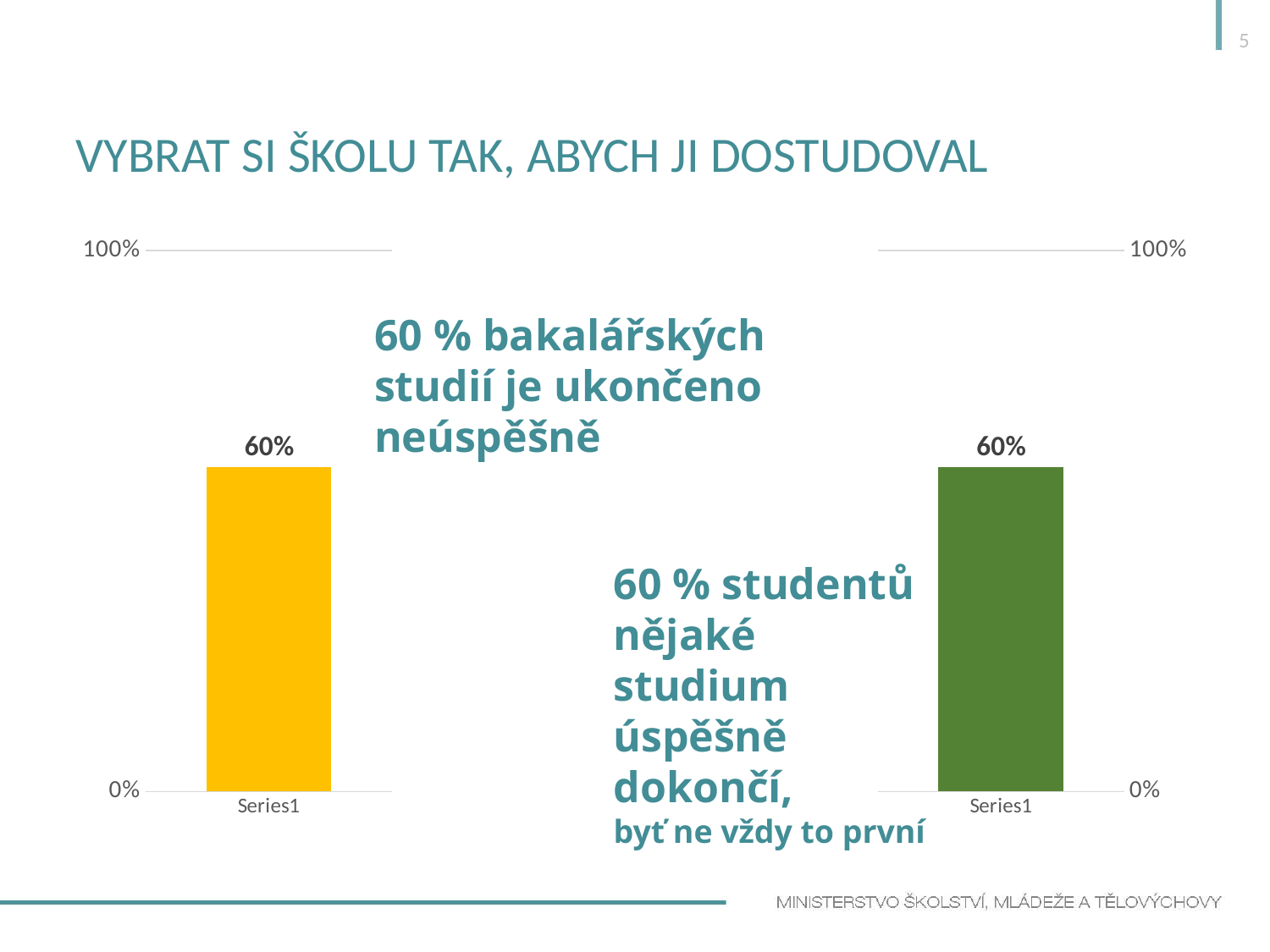
What colour is the bar on the right chart? green How many bars does the left chart show? 1 How many charts are on the slide? 2 On the right chart, what is the value of the bar labelled Series1? 60% What kind of chart is the left chart? bar chart On the left chart, is the value for Series1 greater or less than 100%? less On the left chart, what is the value of the bar labelled Series1? 60% On the right chart, is the value for Series1 greater or less than 0%? greater What kind of chart is the right chart? bar chart What is the difference between the Series1 value on the left chart and the Series1 value on the right chart? 0% What is the maximum value shown on the vertical axis of the left chart? 100% How many bars does the right chart show? 1